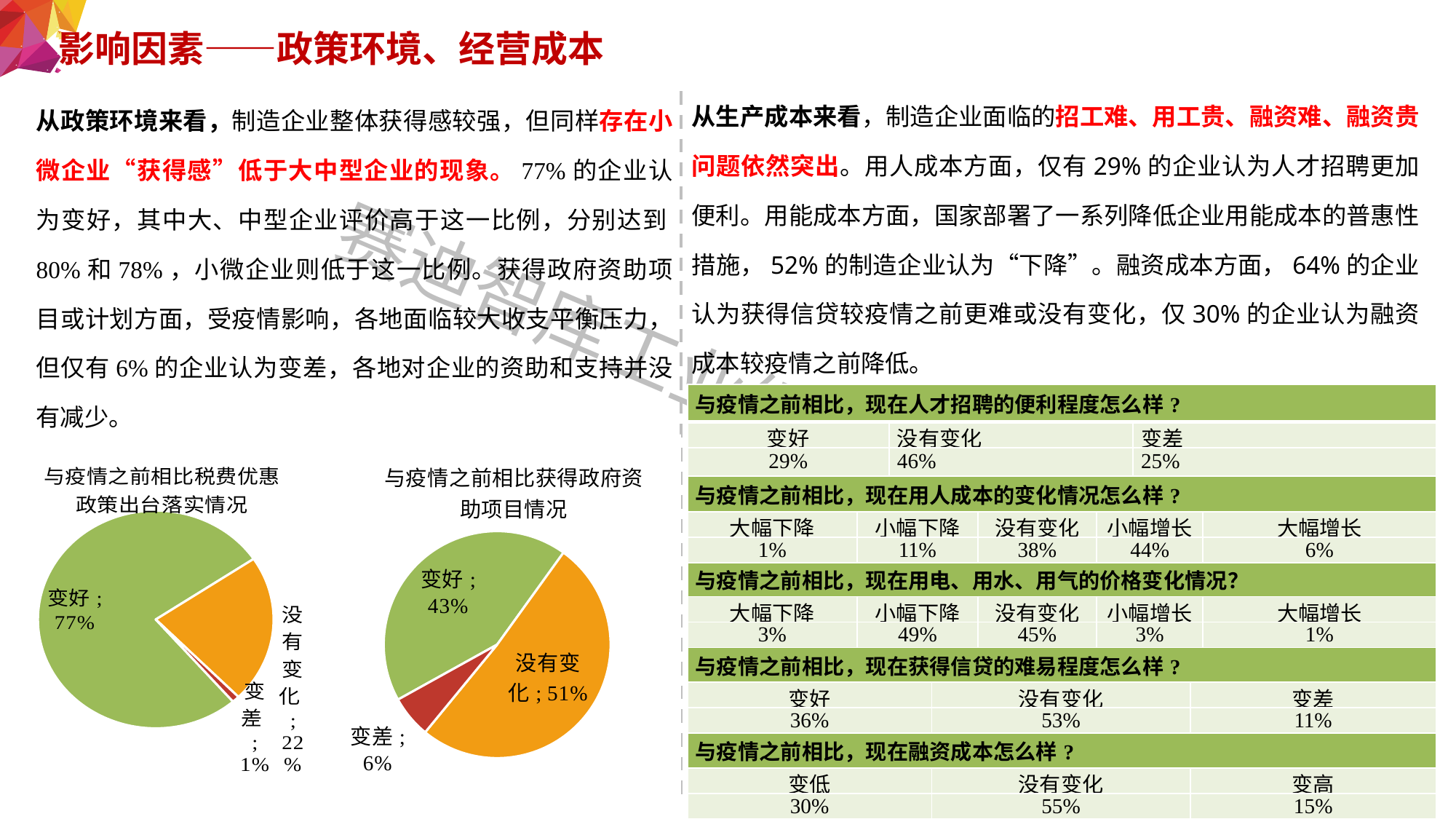
In the pie chart titled 与疫情之前相比税费优惠政策出台落实情况, what share is labelled 变好? 77% How many slices does the pie chart titled 与疫情之前相比获得政府资助项目情况 have? 3 In the pie chart titled 与疫情之前相比获得政府资助项目情况, which slice is the largest? 没有变化 In the pie chart titled 与疫情之前相比税费优惠政策出台落实情况, what share is labelled 没有变化? 22% In the pie chart titled 与疫情之前相比税费优惠政策出台落实情况, which slice is the smallest? 变差 In the pie chart titled 与疫情之前相比获得政府资助项目情况, what is the difference between the 没有变化 share and the 变好 share? 8% In the pie chart titled 与疫情之前相比税费优惠政策出台落实情况, what is the difference between the 变好 share and the 没有变化 share? 55% In the pie chart titled 与疫情之前相比获得政府资助项目情况, what share is labelled 没有变化? 51% What type of chart is used for 与疫情之前相比税费优惠政策出台落实情况? Pie chart In the pie chart titled 与疫情之前相比获得政府资助项目情况, what share is labelled 变差? 6% In the pie chart titled 与疫情之前相比税费优惠政策出台落实情况, which slice is the largest? 变好 Which is larger: the 变好 share in the left pie chart (税费优惠政策) or the 变好 share in the right pie chart (政府资助项目)? Left pie chart (税费优惠政策)